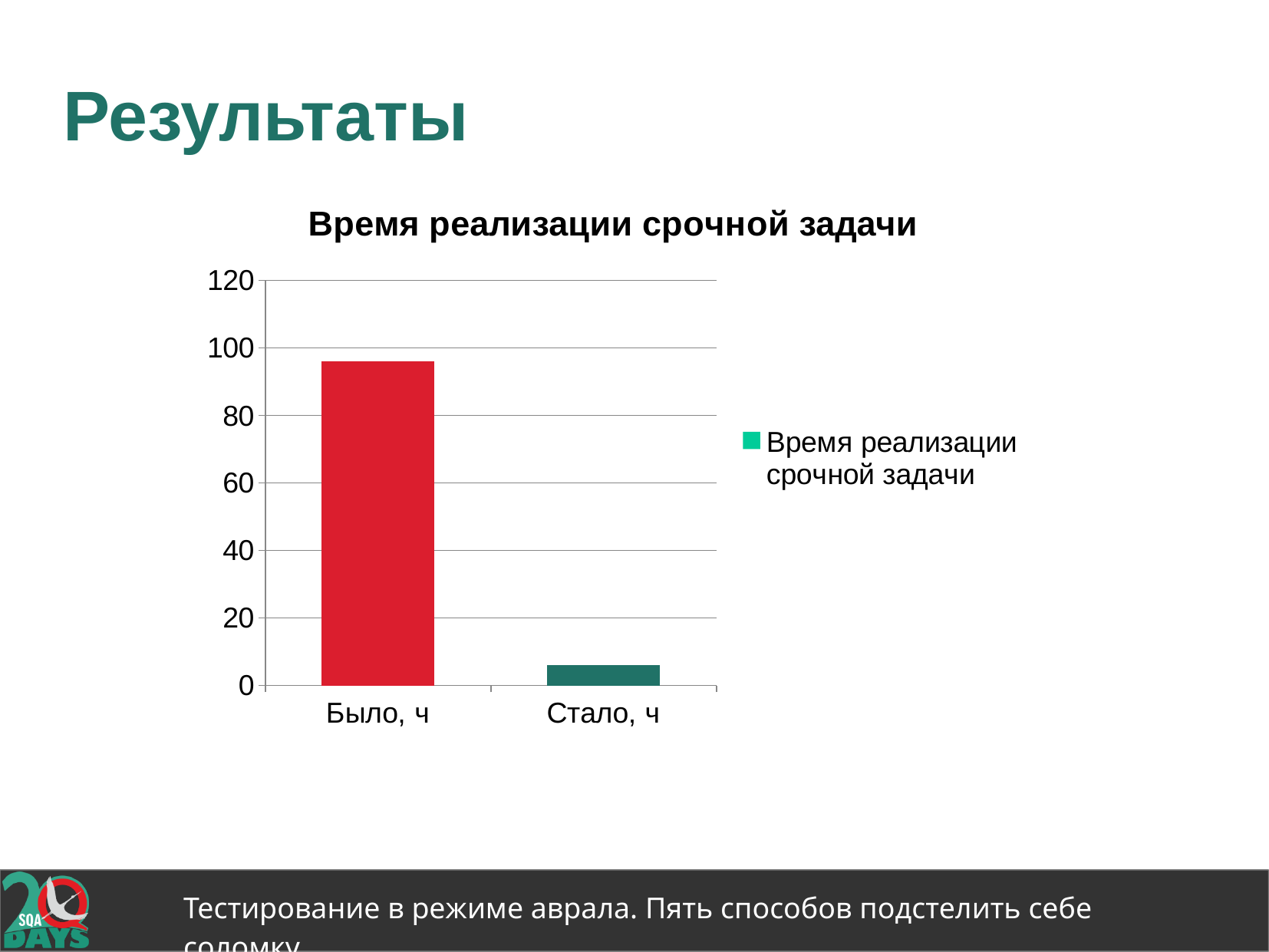
Is the value for Было, ч greater or less than 100? less How many categories are plotted in the chart? 2 Which category has the highest value? Было, ч Which category has the lowest value? Стало, ч Is the value for Стало, ч greater or less than 20? less Is the value for Было, ч greater or less than 80? greater Which is larger, the value for Было, ч or the value for Стало, ч? Было, ч How many series does the legend list? 1 What kind of chart is shown on the slide? bar chart What colour is the bar for Было, ч? red Do the values rise or fall from Было, ч to Стало, ч? fall What is the title of the chart? Время реализации срочной задачи